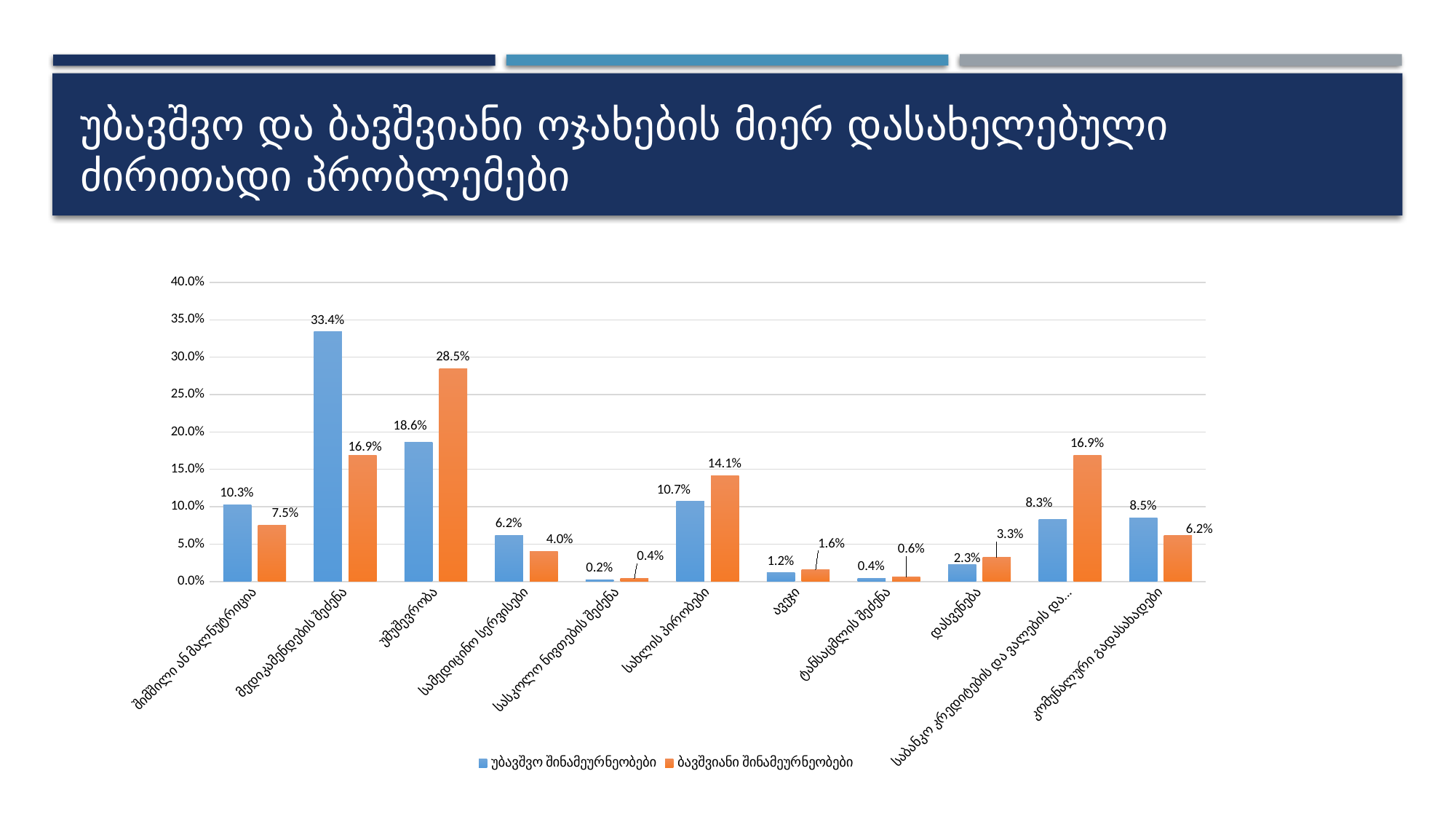
Which category has the highest value for უბავშვო შინამეურნეობები? მედიკამენდების შეძენა Which colour represents ბავშვიანი შინამეურნეობები in the legend? orange Which category has the highest value for ბავშვიანი შინამეურნეობები? უმუშევრობა What type of chart is shown on the slide? bar chart Which category has the lowest value for უბავშვო შინამეურნეობები? სასკოლო ნივთების შეძენა What is the difference between the two series in the category უმუშევრობა? 9.9% What is the value for უბავშვო შინამეურნეობები in the category მედიკამენდების შეძენა? 33.4% In the category სახლის პირობები, which series has the larger value? ბავშვიანი შინამეურნეობები How many categories are shown on the x axis? 11 How many series does the legend list? 2 What is the value for ბავშვიანი შინამეურნეობები in the category დასვენება? 3.3% What is the value for ბავშვიანი შინამეურნეობები in the category უმუშევრობა? 28.5%